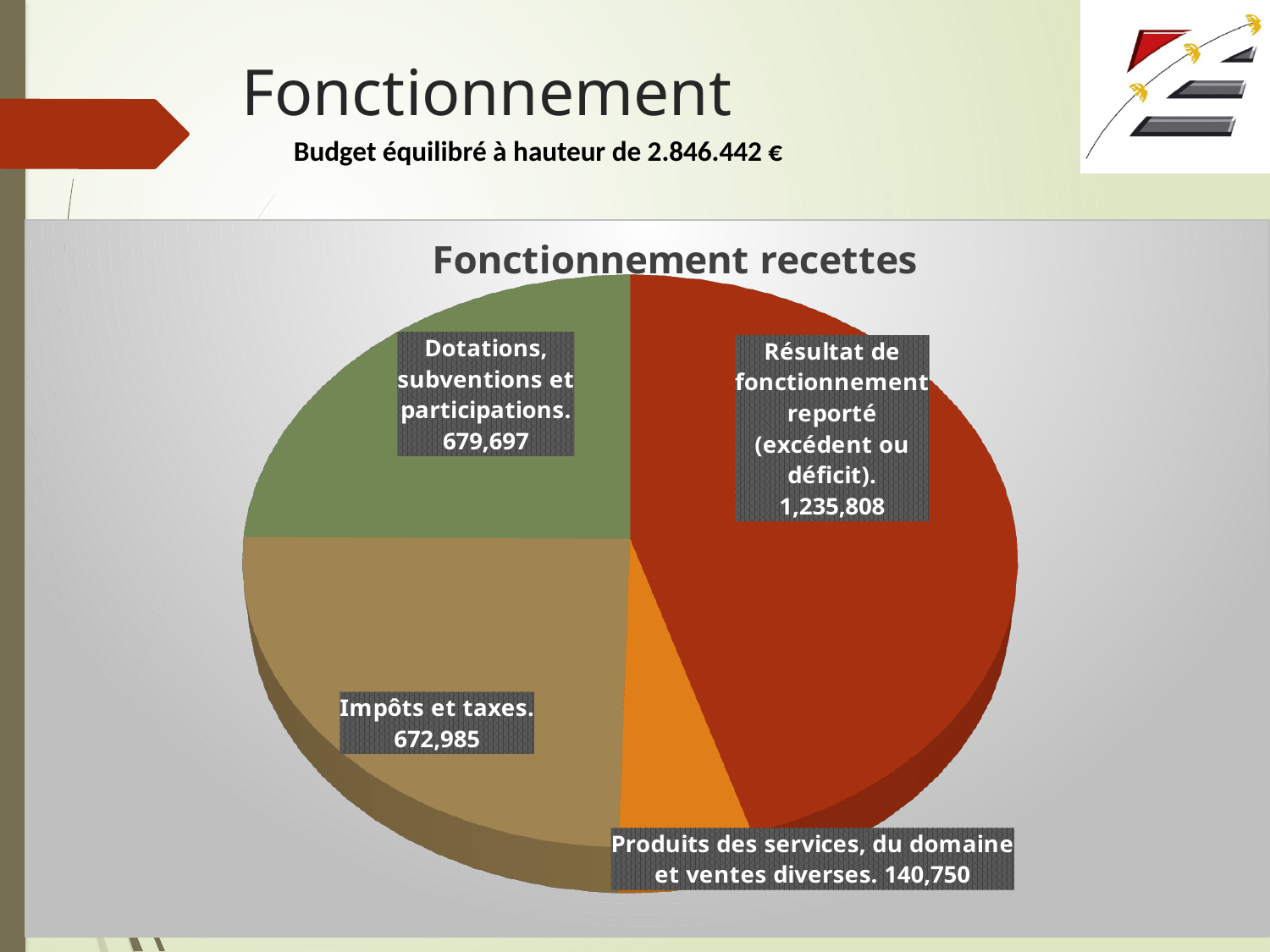
What is the value for Résultat de fonctionnement reporté (excédent ou déficit)? 1,235,808 What is the difference between Résultat de fonctionnement reporté and Dotations, subventions et participations? 556,111 What colour is the slice for Impôts et taxes? Tan (light brown) What is the value for Dotations, subventions et participations? 679,697 Which is larger: Impôts et taxes or Produits des services, du domaine et ventes diverses? Impôts et taxes What type of chart is shown on the slide? Pie chart What is the value for Produits des services, du domaine et ventes diverses? 140,750 What is the title of the chart? Fonctionnement recettes How many slices does the pie chart have? 4 Which category has the smallest slice of the pie? Produits des services, du domaine et ventes diverses What is the value for Impôts et taxes? 672,985 Which category has the largest slice of the pie? Résultat de fonctionnement reporté (excédent ou déficit)